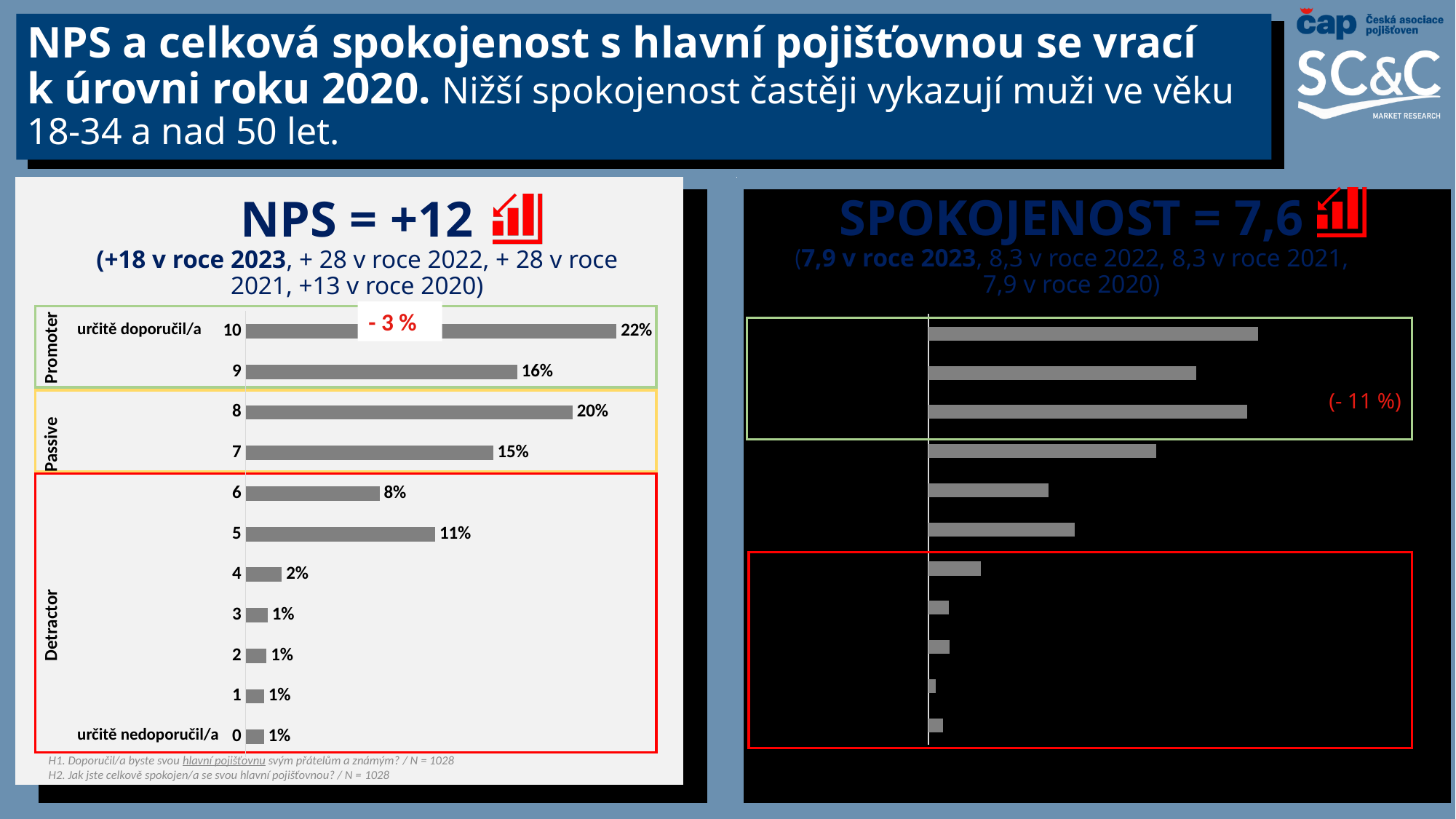
In the NPS chart on the left, what percentage of respondents gave a score of 10 (určitě doporučil/a)? 22% In the NPS chart on the left, what is the combined percentage of the Promoter group (scores 10 and 9)? 38% In the NPS chart on the left, how many score categories are plotted? 11 In the NPS chart on the left, what is the combined percentage of the Passive group (scores 8 and 7)? 35% In the NPS chart on the left, what is the value for score 5? 11% In the NPS chart on the left, which score has the highest percentage? 10 What NPS value is stated in the title of the left chart? +12 In the NPS chart on the left, which has the larger value, score 8 or score 7? 8 In the NPS chart on the left, what is the value for score 8? 20% What kind of chart is the NPS chart on the left? Bar chart In the NPS chart on the left, what is the value for score 6? 8% In the NPS chart on the left, what is the difference between the values for score 10 and score 9? 6%